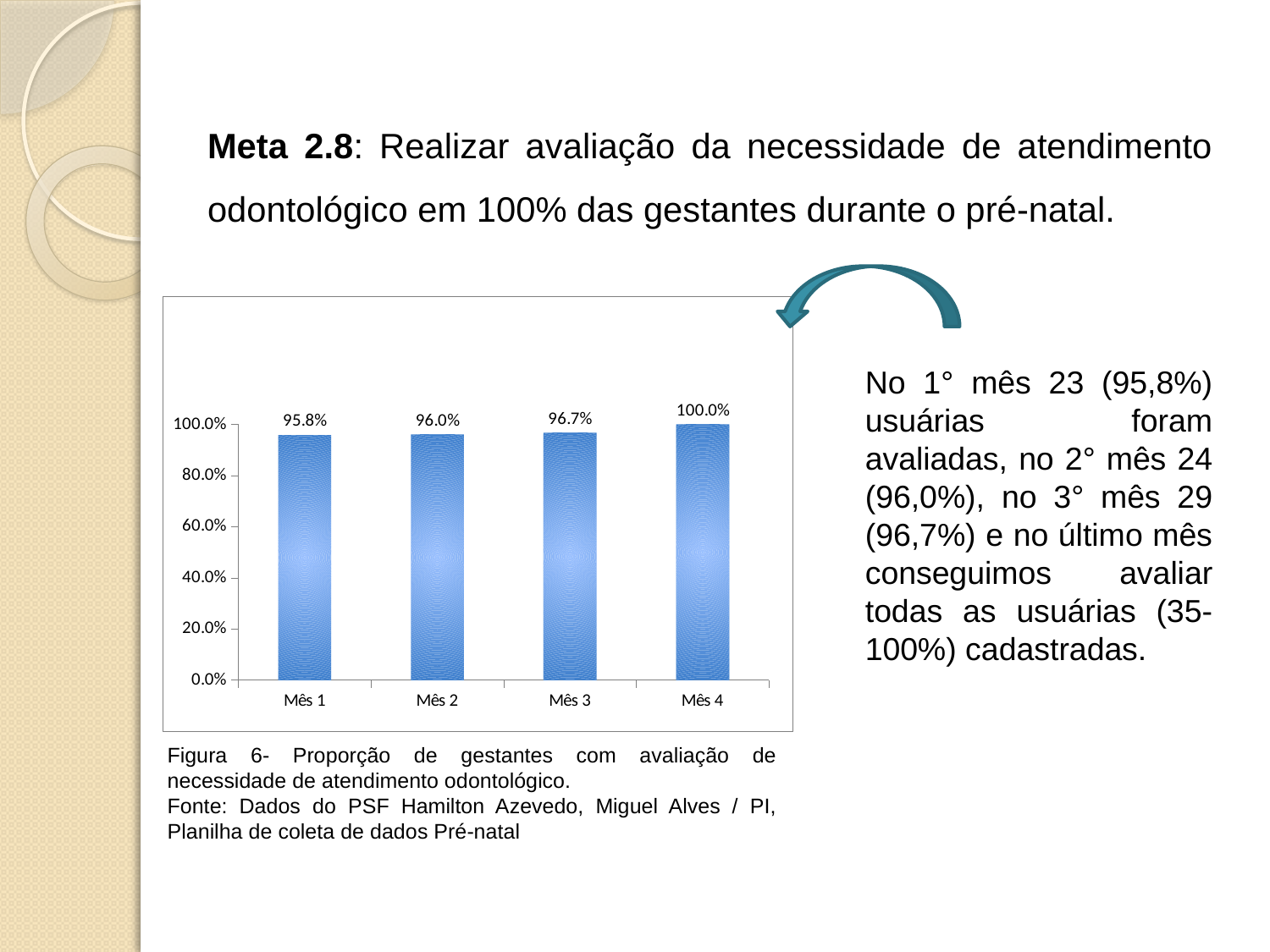
What is the value for Mês 4? 100.0% Do the values rise or fall from Mês 1 to Mês 4? Rise Which is larger, the value for Mês 3 or the value for Mês 2? Mês 3 How many months are shown on the x axis? 4 What is the difference between the values for Mês 3 and Mês 2? 0.7% Which month has the highest value? Mês 4 Which month has the lowest value? Mês 1 What is the value for Mês 2? 96.0% What is the value for Mês 1? 95.8% What is the difference between the values for Mês 4 and Mês 1? 4.2% What kind of chart is shown on the slide? Bar chart What is the value for Mês 3? 96.7%